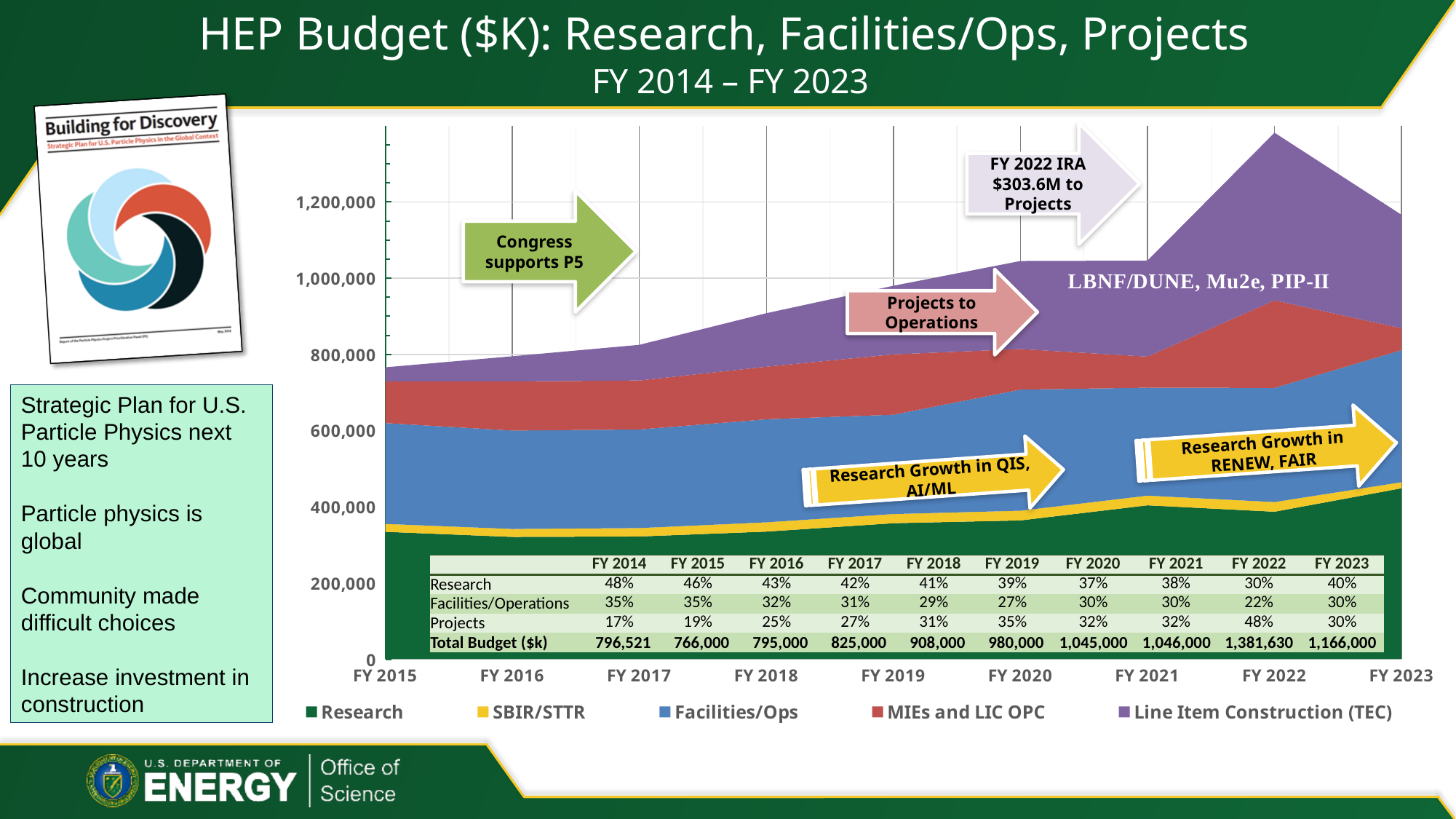
Is the total stacked value of the chart at FY 2022 greater or less than 1,200,000? greater Which fiscal year in the table has the lowest Total Budget ($k)? FY 2015 According to the table, what percentage of the budget went to Research in FY 2023? 40% Which year had a larger Projects share of the budget, FY 2022 or FY 2023? FY 2022 What kind of chart is shown on the slide? Stacked area chart According to the table on the chart, what is the Total Budget ($k) for FY 2022? 1,381,630 How many fiscal years are shown along the x axis of the chart? 9 According to the table, what percentage of the budget went to Facilities/Operations in FY 2019? 27% Which fiscal year in the table has the highest Total Budget ($k)? FY 2022 How many series does the chart legend list? 5 Which colour represents Line Item Construction (TEC) in the chart legend? Purple By how much did the Total Budget ($k) fall from FY 2022 to FY 2023, according to the table? 215,630